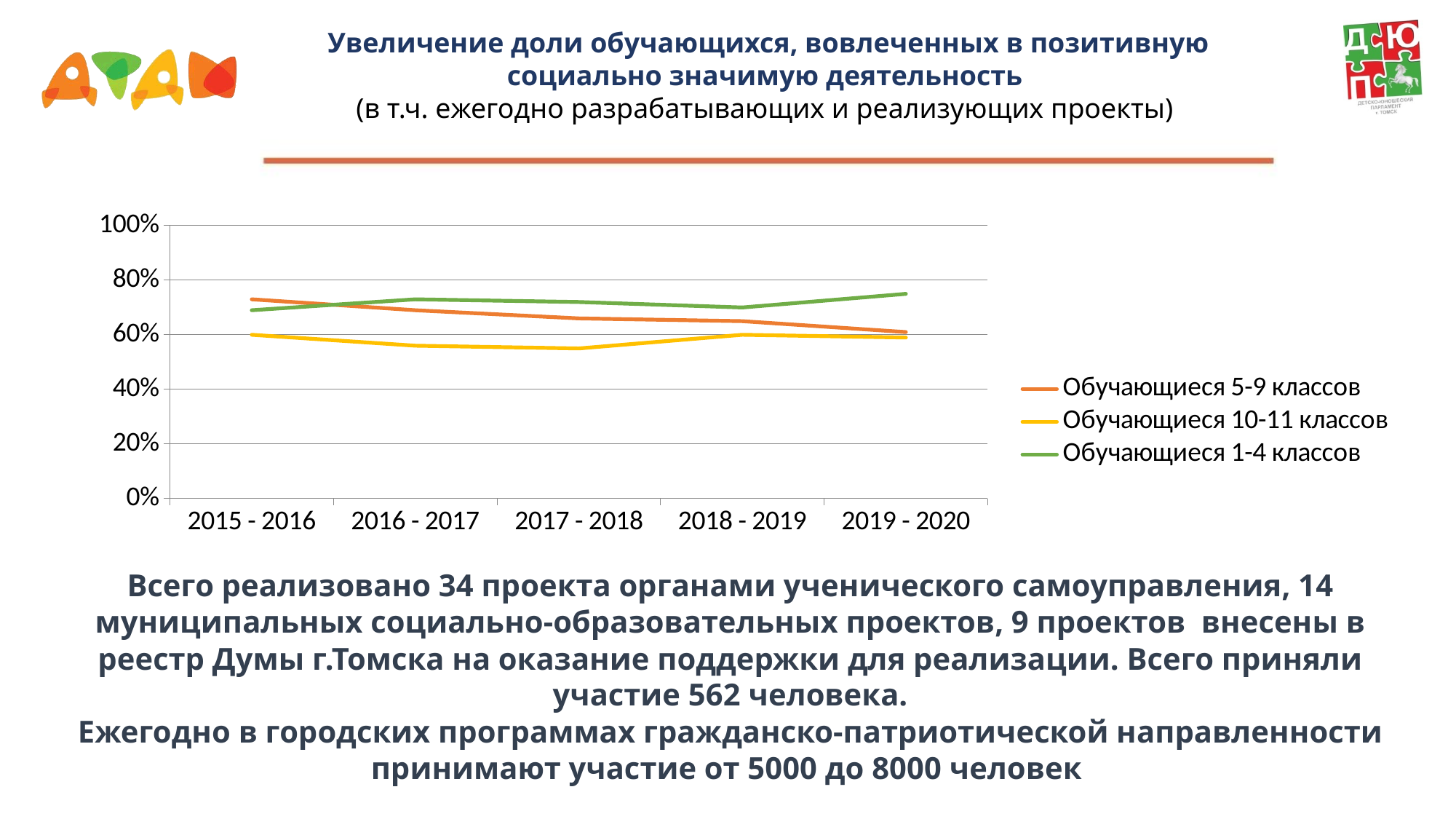
Is the value for Обучающиеся 1-4 классов in 2019 - 2020 greater or less than 80%? less Which series has the lowest value in 2017 - 2018? Обучающиеся 10-11 классов Which series has the highest value in 2019 - 2020? Обучающиеся 1-4 классов How many school-year categories are shown on the x axis? 5 Is the value for Обучающиеся 5-9 классов in 2015 - 2016 greater or less than 60%? greater Is the value for Обучающиеся 10-11 классов in 2017 - 2018 greater or less than 60%? less Does the line for Обучающиеся 5-9 классов rise or fall from 2015 - 2016 to 2019 - 2020? fall What colour is the line for Обучающиеся 1-4 классов? green How many series does the chart legend list? 3 In 2019 - 2020, which is larger: Обучающиеся 1-4 классов or Обучающиеся 10-11 классов? Обучающиеся 1-4 классов What kind of chart is shown on the slide? line chart